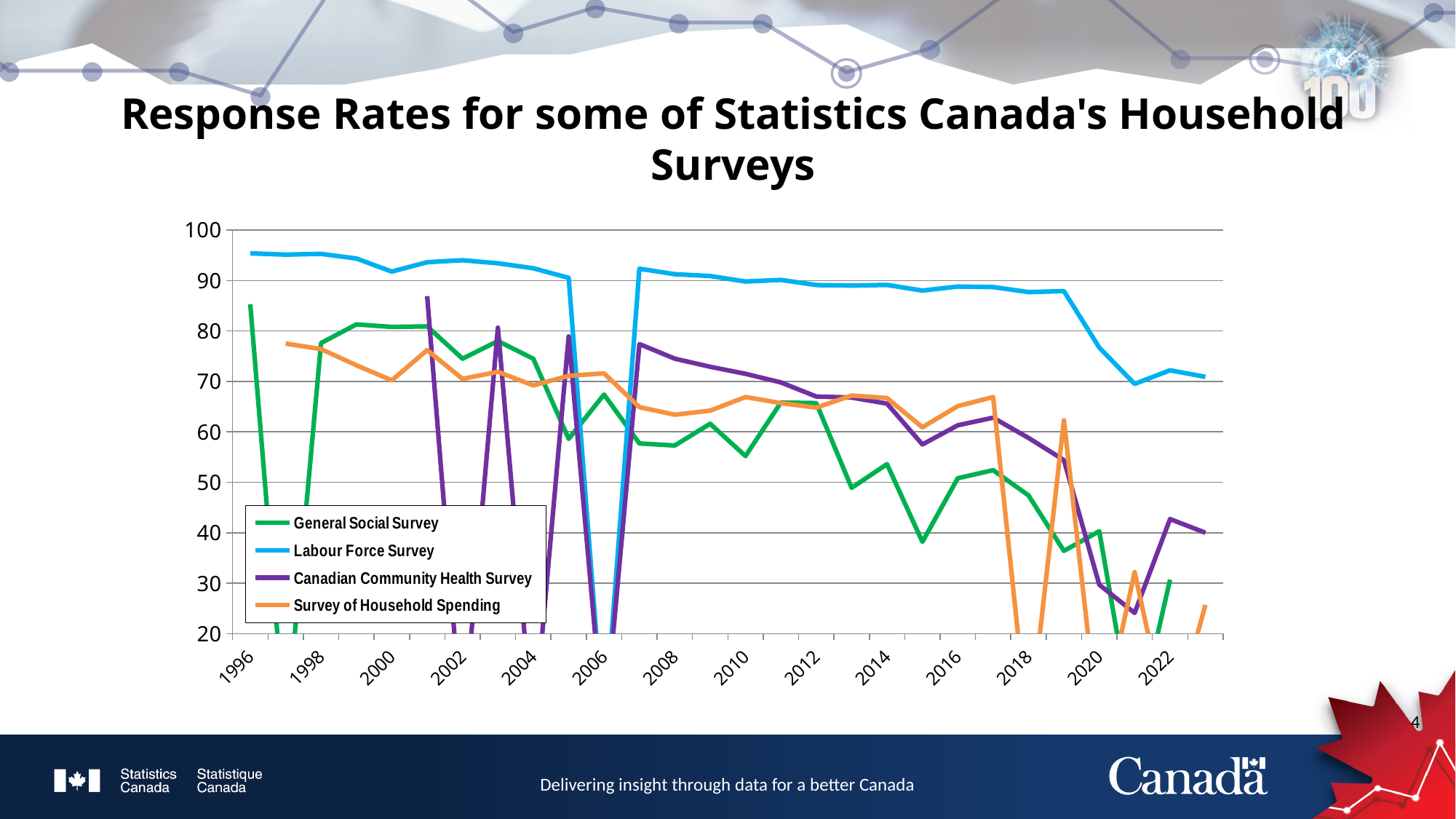
Does the response rate for the Labour Force Survey rise or fall overall from 1996 to 2022? fall Is the response rate for the Labour Force Survey in 1996 greater or less than 90? greater What is the title of the chart? Response Rates for some of Statistics Canada's Household Surveys Which surveys are listed in the legend? General Social Survey, Labour Force Survey, Canadian Community Health Survey, Survey of Household Spending In 2012, which has the higher response rate: the Labour Force Survey or the General Social Survey? Labour Force Survey What kind of chart is shown on the slide? line chart How many series does the legend list? 4 Is the response rate for the Canadian Community Health Survey in 2008 greater or less than 70? greater Which survey has the highest response rate in 2000? Labour Force Survey Is the response rate for the Survey of Household Spending in 2010 greater or less than 60? greater How many year labels are shown on the x axis? 14